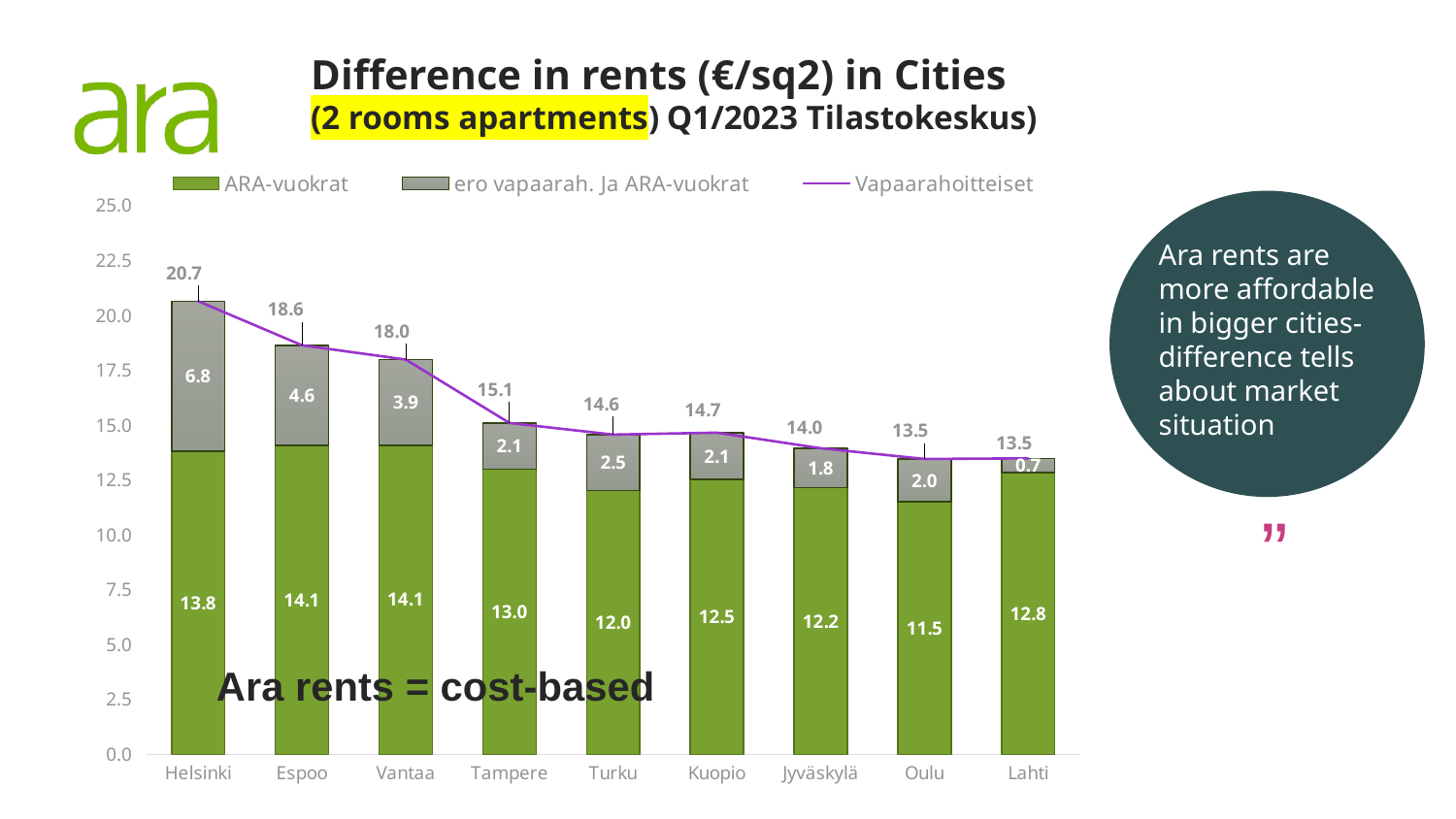
How many cities are shown on the x axis? 9 Does the Vapaarahoitteiset line rise or fall from Helsinki to Lahti? Fall What is the Vapaarahoitteiset value for Tampere? 15.1 What is the Vapaarahoitteiset value for Helsinki? 20.7 Which city has the lowest ARA-vuokrat value? Oulu What is the ARA-vuokrat value for Helsinki? 13.8 Which city has the highest 'ero vapaarah. Ja ARA-vuokrat' value? Helsinki Which city has the larger ARA-vuokrat value, Tampere or Turku? Tampere Which city has the lowest 'ero vapaarah. Ja ARA-vuokrat' value? Lahti What is the 'ero vapaarah. Ja ARA-vuokrat' value for Helsinki? 6.8 How many series does the legend list? 3 What is the difference between the ARA-vuokrat values for Espoo and Oulu? 2.6